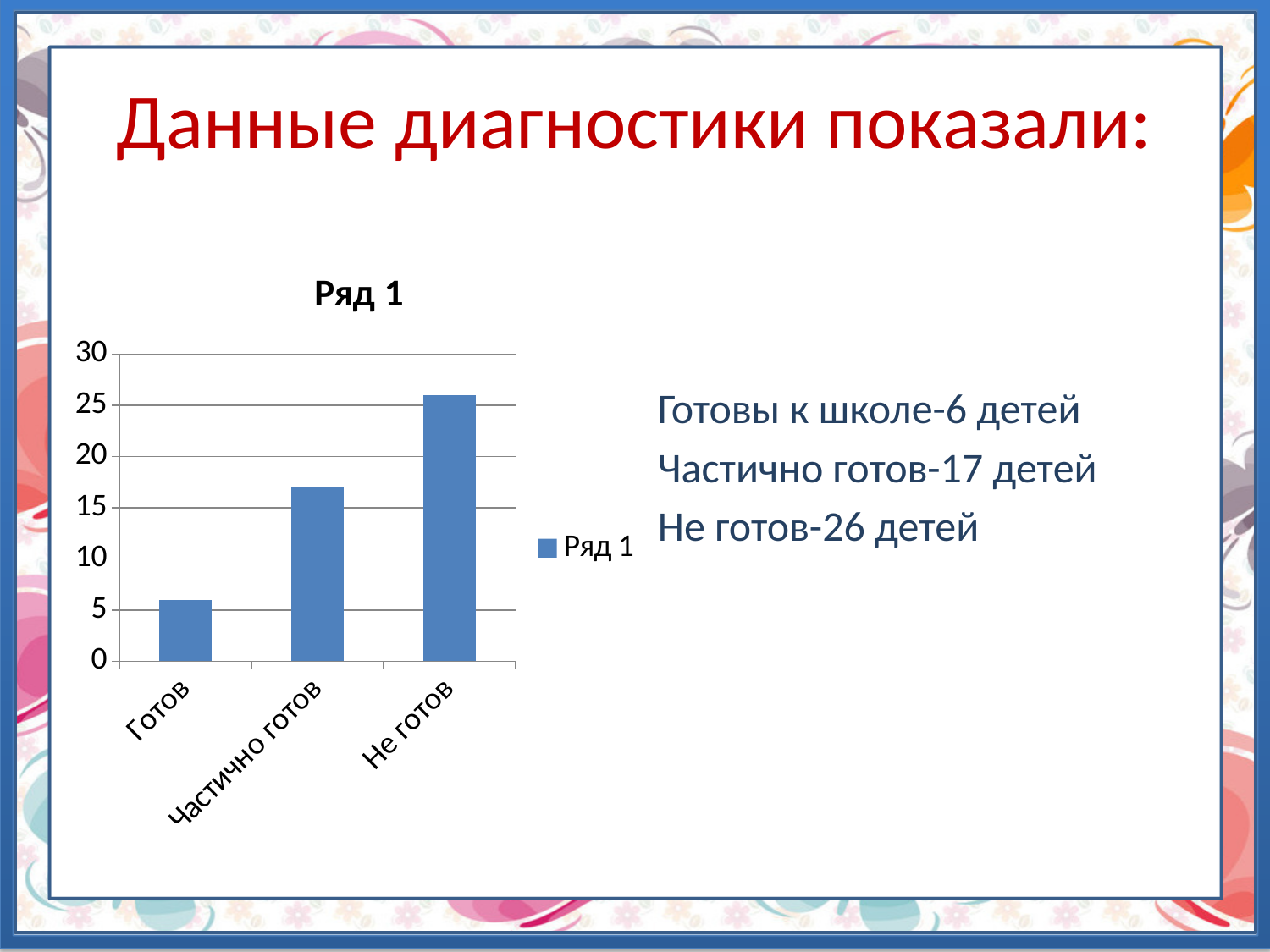
What type of chart is shown on the slide? bar chart How many categories are shown on the x axis of the chart? 3 Is the value for Готов greater or less than 10? less Which category has the lowest bar in the chart? Готов What is the value for Готов according to the slide? 6 Which is larger: the bar for Частично готов or the bar for Готов? Частично готов How many series does the chart legend list? 1 Do the bar values rise or fall from left to right along the x axis? rise Which category has the highest bar in the chart? Не готов What is the value for Частично готов according to the slide? 17 What is the value for Не готов according to the slide? 26 Is the value for Не готов greater or less than 25? greater